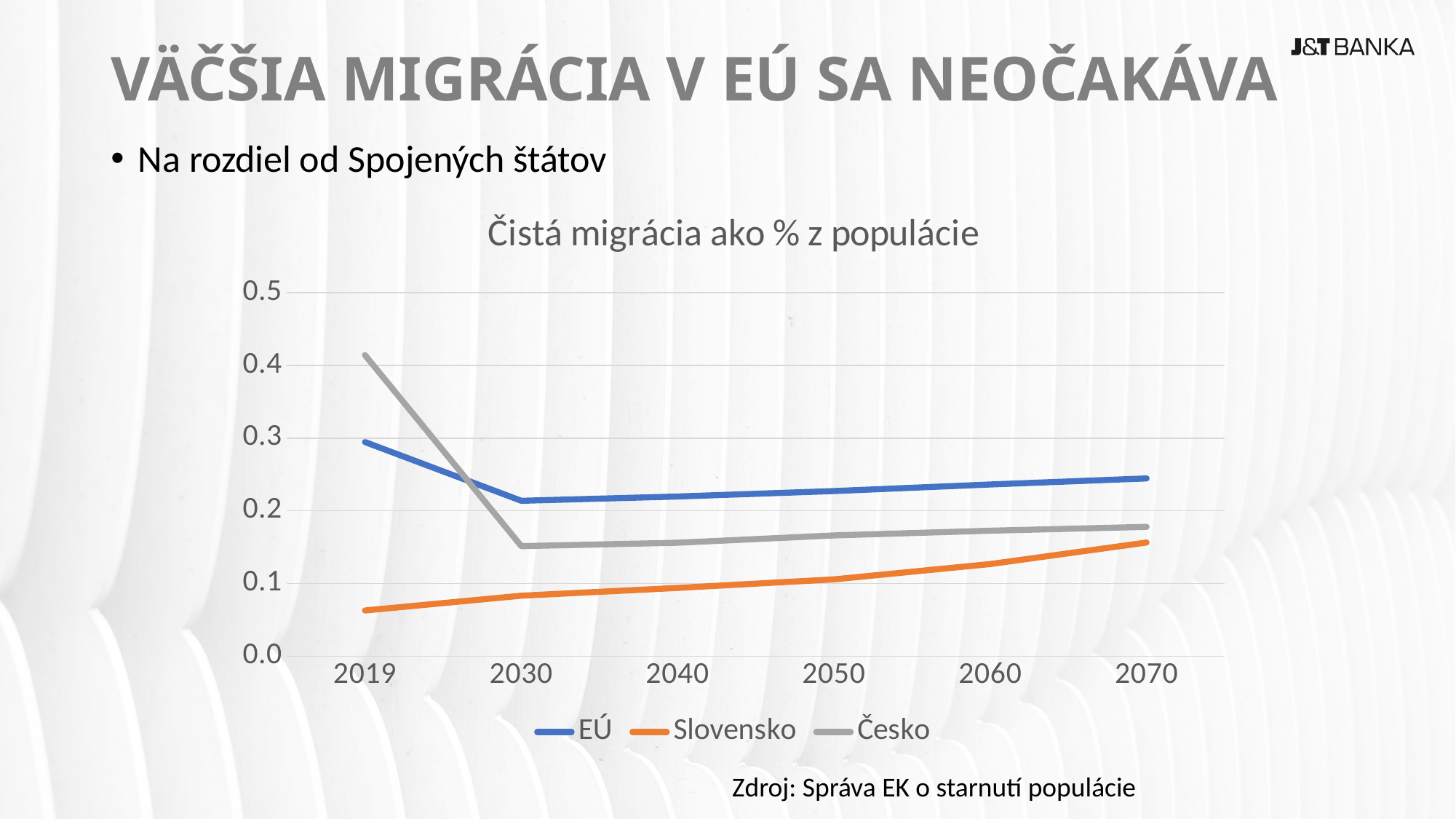
Is the value for Slovensko in 2019 greater or less than 0.1? less How many series does the legend list? 3 What kind of chart is shown on the slide? line chart Is the value for EÚ in 2070 greater or less than 0.2? greater Is the value for Česko in 2030 greater or less than 0.2? less How many years are shown on the x axis? 6 What is the title of the chart? Čistá migrácia ako % z populácie Which series has the lowest value in 2070? Slovensko Which is larger in 2019, the value for Česko or the value for EÚ? Česko Which series has the highest value in 2070? EÚ Does the value for Slovensko rise or fall from 2019 to 2070? rise Which series has the highest value in 2019? Česko